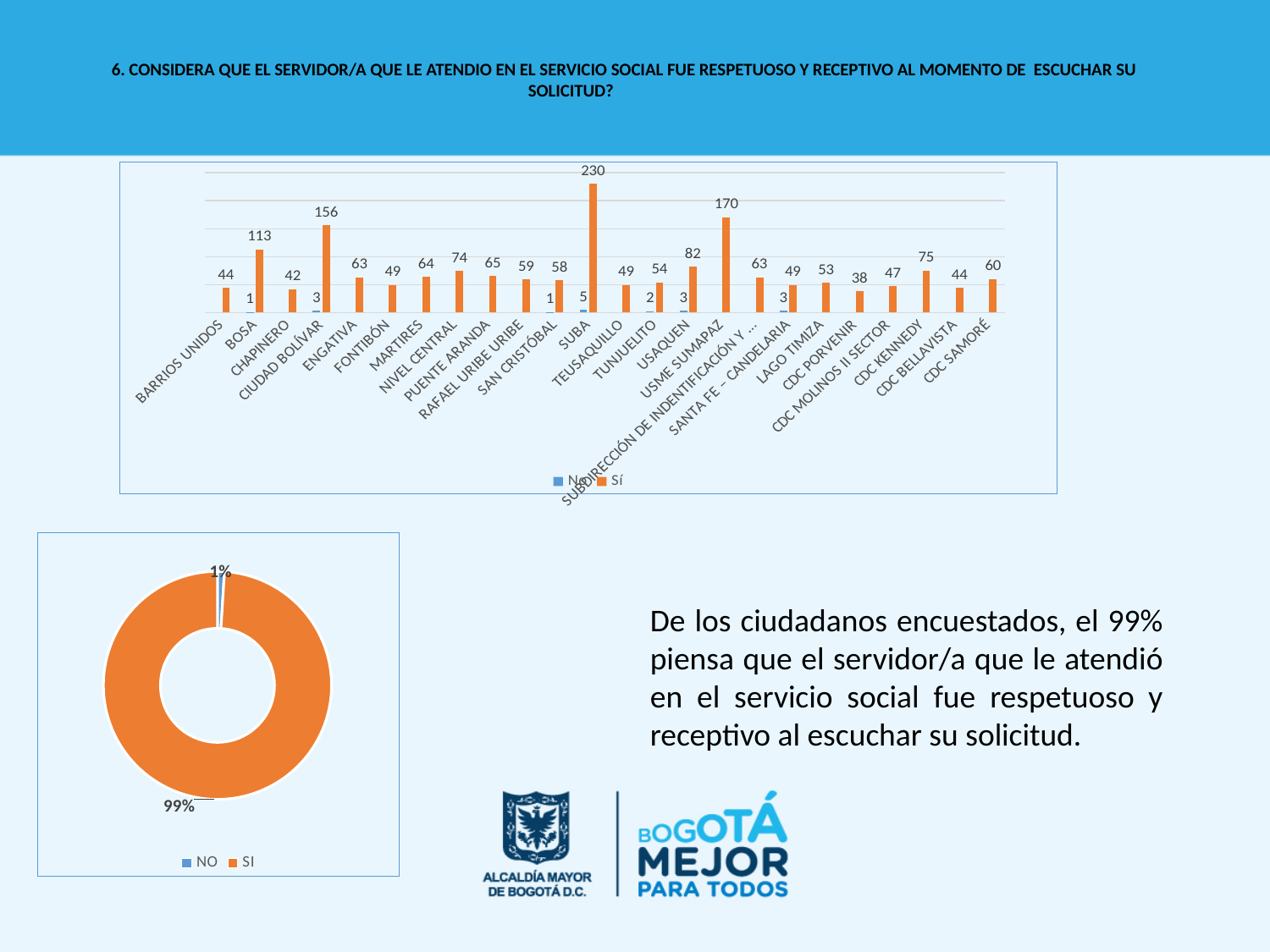
What kind of chart is the top chart on the slide? Bar chart In the top bar chart, which has a larger 'Sí' value, BOSA or USAQUEN? BOSA In the top bar chart, what is the 'Sí' value for SUBA? 230 In the top bar chart, which category has the lowest 'Sí' value? CDC PORVENIR In the top bar chart, what is the 'Sí' value for CIUDAD BOLÍVAR? 156 In the bottom doughnut chart, what share is labelled for NO? 1% How many series does the legend of the top bar chart list? 2 In the bottom doughnut chart, what share is labelled for SI? 99% In the top bar chart, what is the 'No' value for SUBA? 5 In the top bar chart, which category has the highest 'Sí' value? SUBA In the top bar chart, what is the difference between the 'Sí' values for SUBA and USME SUMAPAZ? 60 What kind of chart is the bottom-left chart on the slide? Doughnut chart